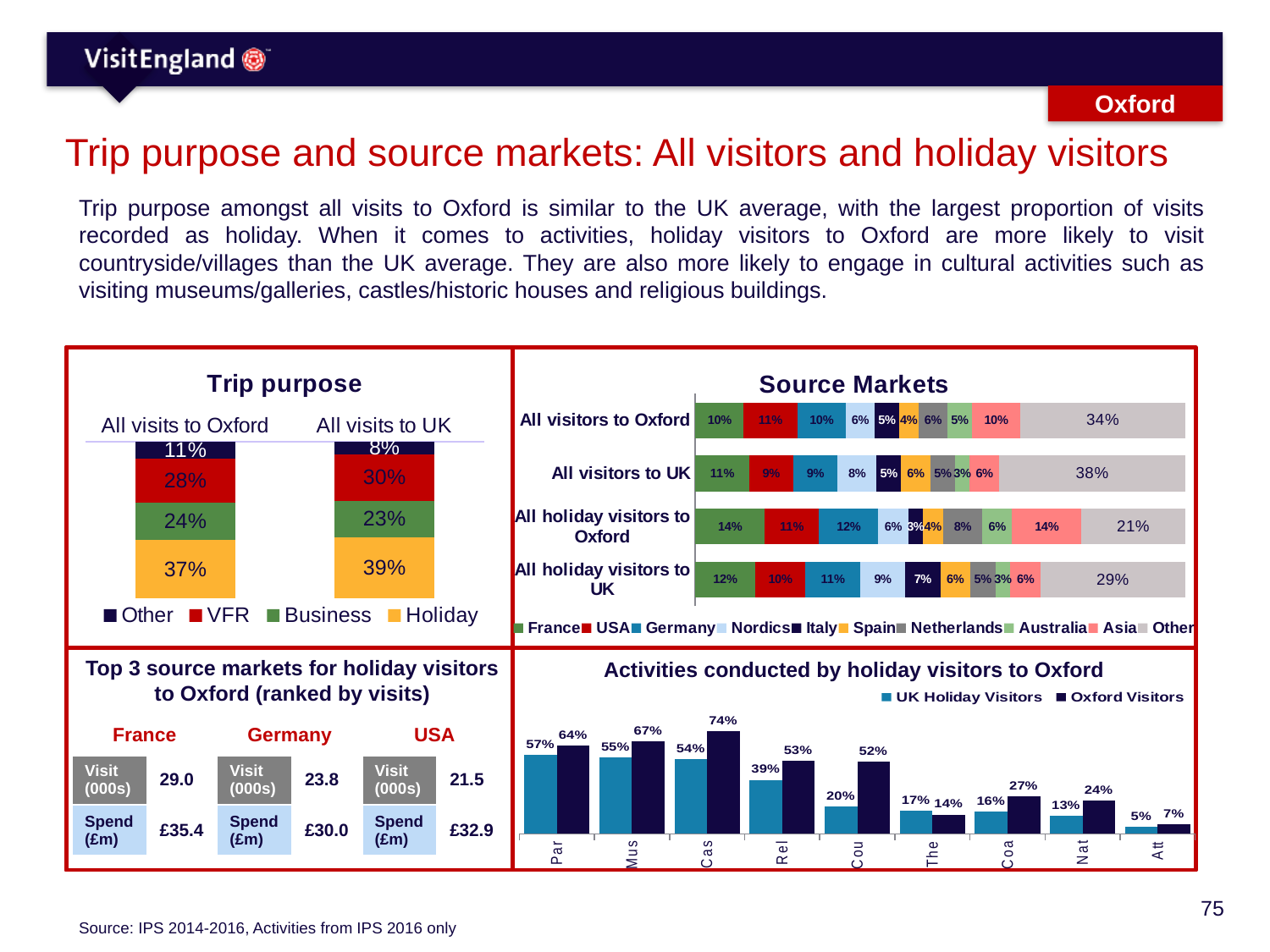
In the Top 3 source markets for holiday visitors to Oxford panel, what is the spend (£m) for Germany? £30.0 In the Activities conducted by holiday visitors to Oxford chart, what is the value for Oxford Visitors for the 'Cas' category? 74% In the Trip purpose chart, which trip purpose has the smallest share for all visits to UK? Other What type of chart is the Activities conducted by holiday visitors to Oxford chart? Bar chart How many series does the legend of the Trip purpose chart list? 4 In the Activities conducted by holiday visitors to Oxford chart, what is the difference between Oxford Visitors and UK Holiday Visitors for the 'Cou' category? 32 percentage points How many source markets does the legend of the Source Markets chart list? 10 In the Trip purpose chart, what percentage of all visits to Oxford are Holiday visits? 37% In the Source Markets chart, what percentage of all visitors to Oxford come from the 'Other' markets? 34% In the Source Markets chart, what share of all holiday visitors to Oxford come from France? 14% In the Trip purpose chart, what is the difference between the Holiday share for all visits to UK and for all visits to Oxford? 2 percentage points In the Source Markets chart, is the 'Other' share larger for all visitors to UK or for all visitors to Oxford? All visitors to UK